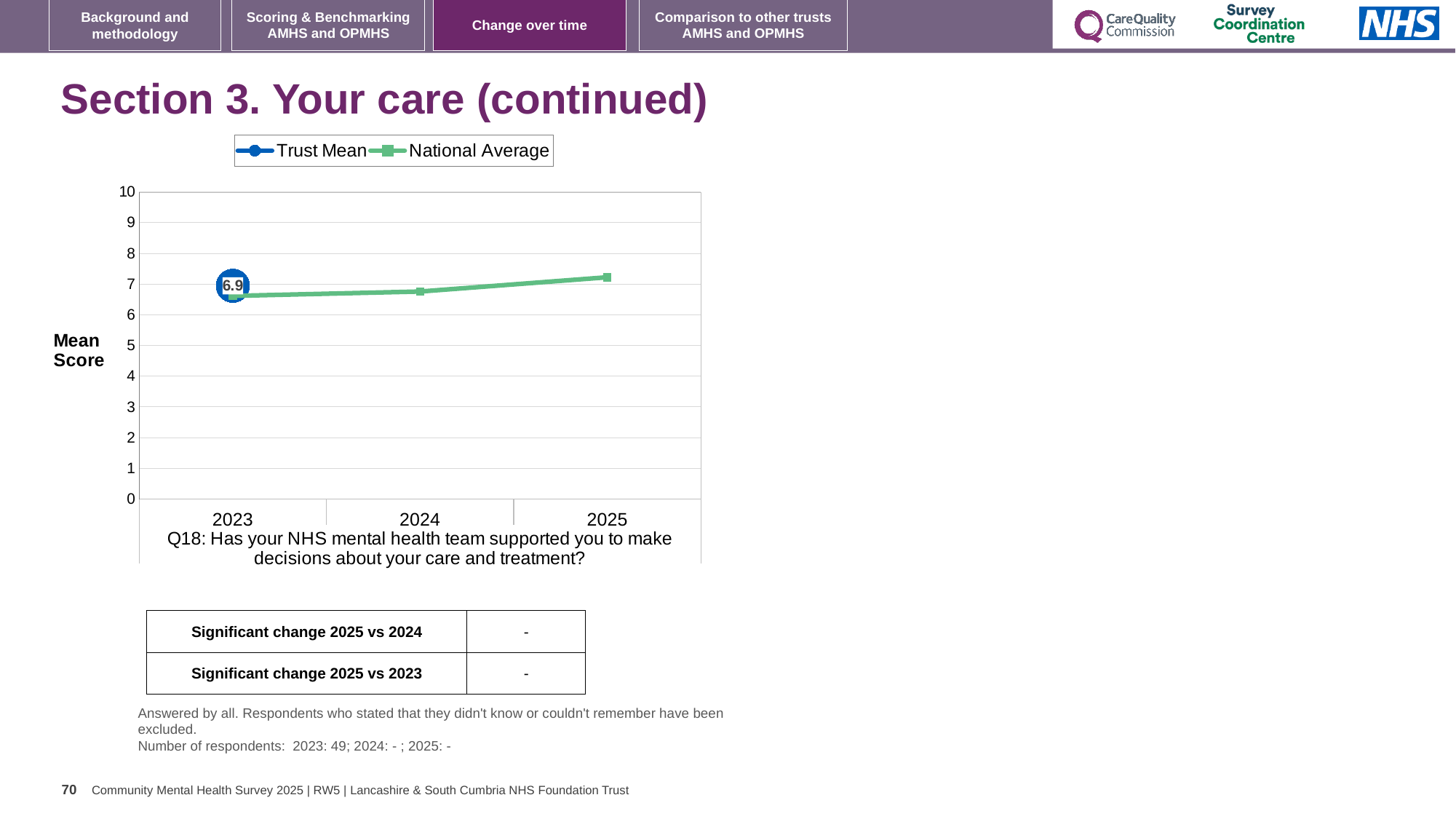
In which year is the National Average highest? 2025 Does the National Average rise or fall from 2023 to 2025? rise Is the National Average for 2025 greater or less than 6? greater How many series does the legend list? 2 How many years are shown on the x axis? 3 In 2023, which is larger: the Trust Mean or the National Average? Trust Mean Which series is shown with a green line in the legend? National Average Is the National Average for 2023 greater or less than 7? less In which year is the National Average lowest? 2023 What is the label on the y axis? Mean Score What kind of chart is shown on the slide? line chart What is the Trust Mean score for 2023? 6.9